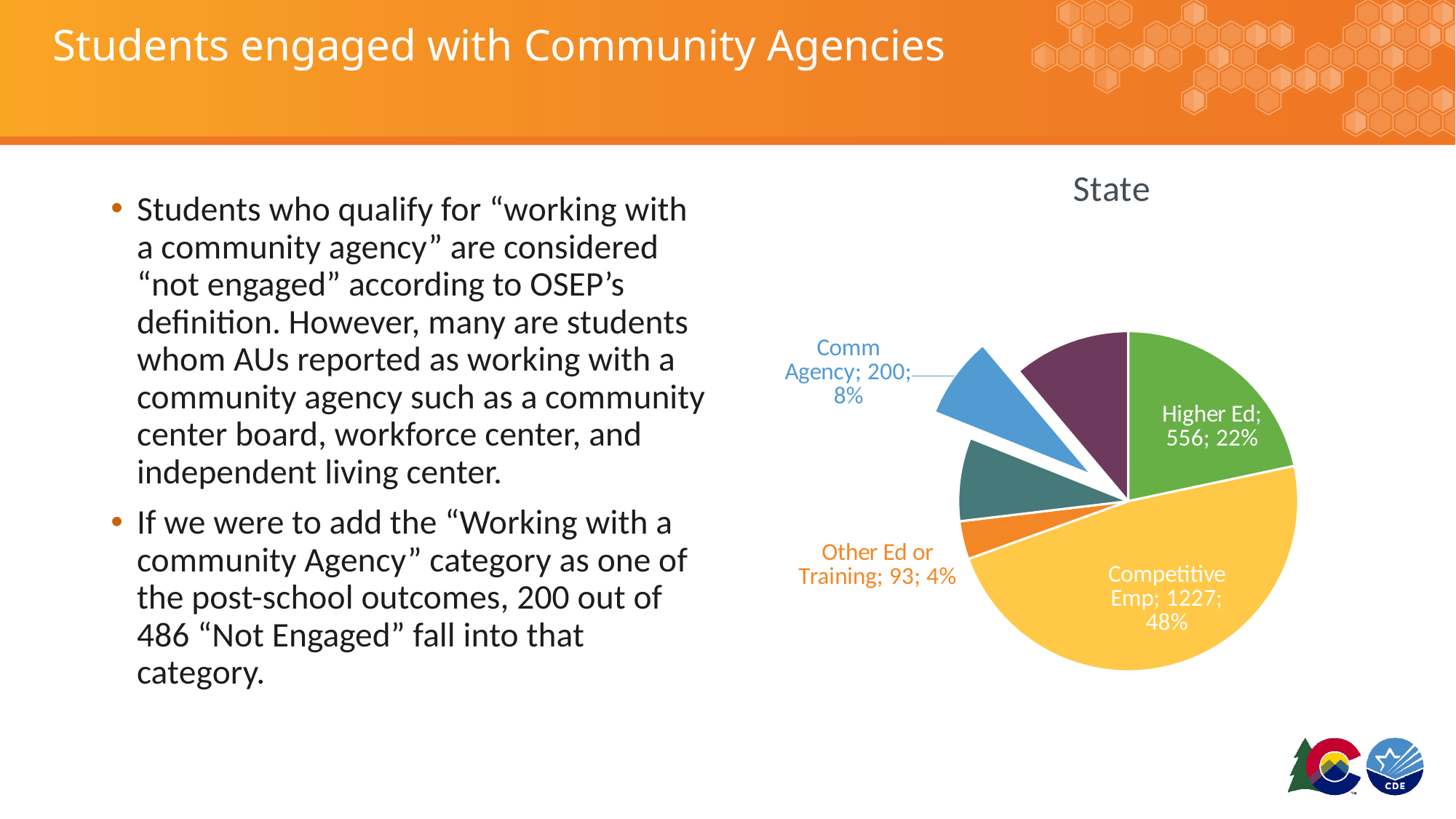
How many students are in the Other Ed or Training slice? 93 How many students are in the Comm Agency slice? 200 What share of the pie does Higher Ed represent? 22% Which category has the smallest slice of the pie? Other Ed or Training Which category has the largest slice of the pie? Competitive Emp How many students are in the Competitive Emp slice? 1227 What is the difference between the Competitive Emp count and the Higher Ed count? 671 What share of the pie does Comm Agency represent? 8% What is the title of the chart? State How many students are in the Higher Ed slice? 556 What share of the pie does Competitive Emp represent? 48% What type of chart is shown on the slide? Pie chart